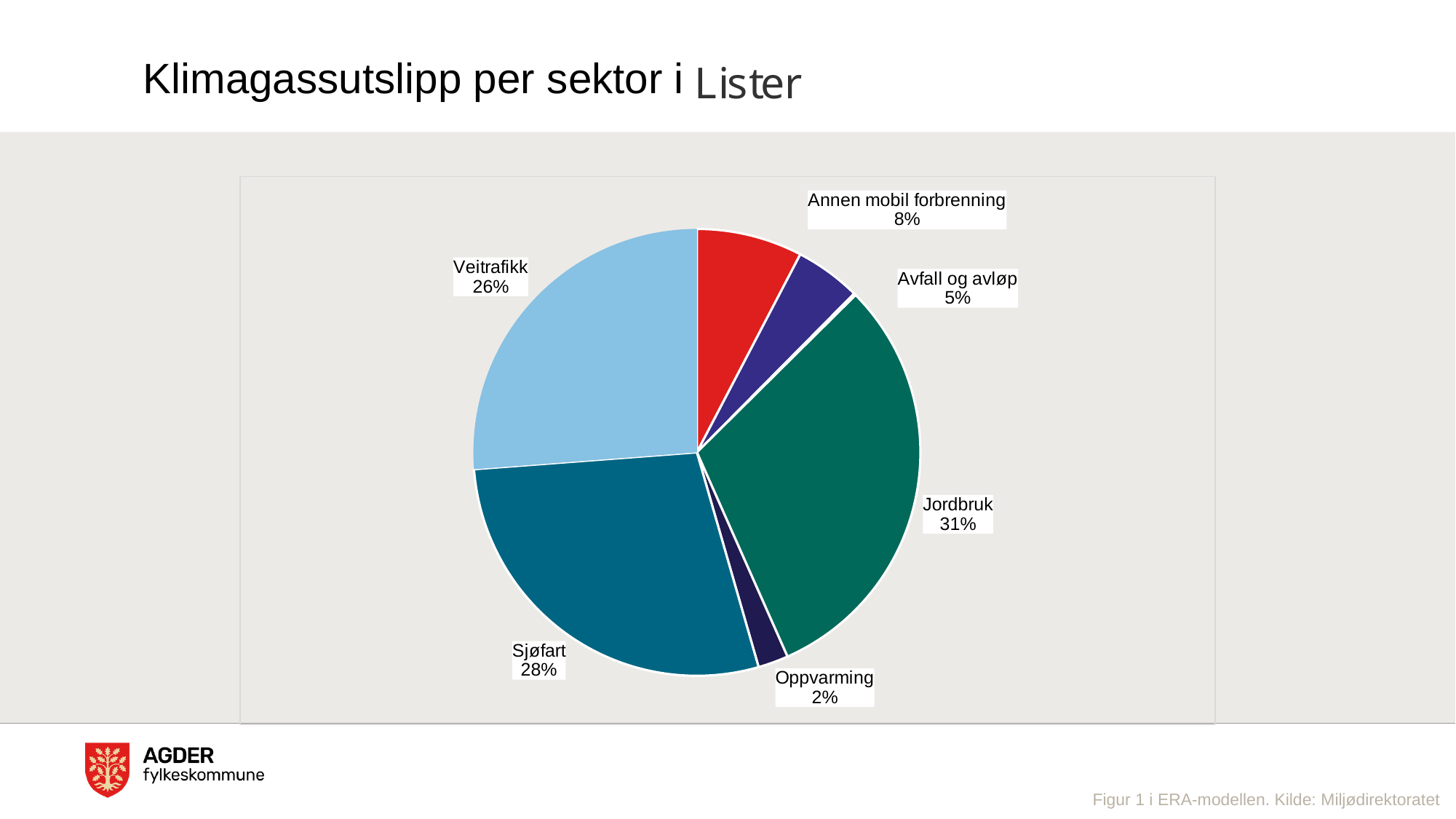
What share of emissions does Annen mobil forbrenning account for? 8% What share of emissions does Veitrafikk account for? 26% What share of emissions does Sjøfart account for? 28% Which sector has the smallest share of emissions? Oppvarming What is the title of the slide containing the chart? Klimagassutslipp per sektor i Lister Which sector has the largest share of emissions? Jordbruk What is the difference in percentage points between Jordbruk and Veitrafikk? 5 What kind of chart is shown on the slide? pie chart Which is larger, the share for Annen mobil forbrenning or the share for Avfall og avløp? Annen mobil forbrenning How many sectors are shown in the pie chart? 6